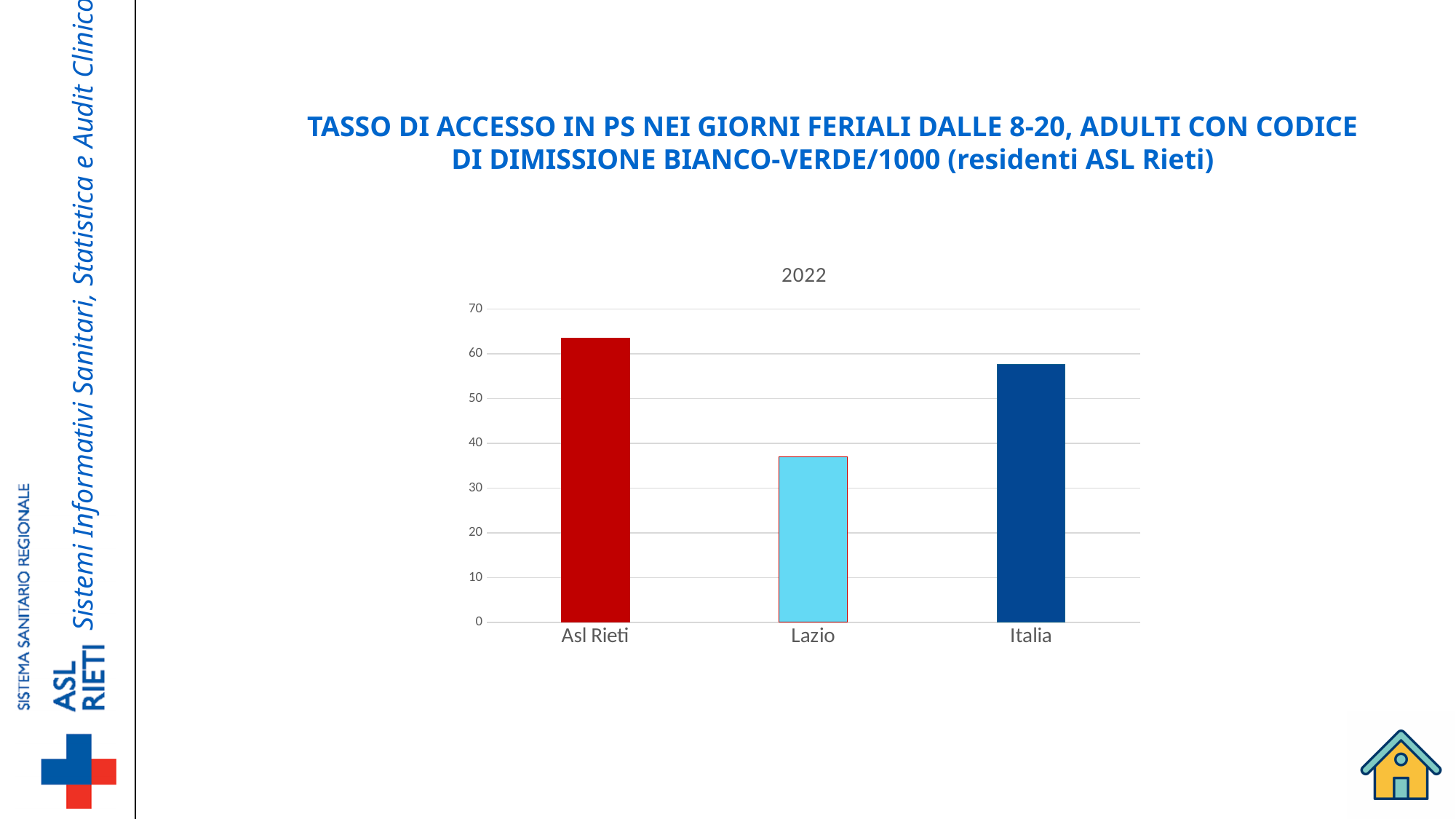
Is the value for Asl Rieti greater or less than 60? greater What colour is the bar for Lazio? light blue What year is shown as the chart title above the plot area? 2022 Is the value for Lazio greater or less than 40? less Which category has the lowest value? Lazio How many categories are plotted on the x axis? 3 Is the value for Italia greater or less than 60? less What kind of chart is shown on the slide? bar chart Which is larger, the value for Asl Rieti or the value for Italia? Asl Rieti Which is larger, the value for Lazio or the value for Italia? Italia Which category has the highest value? Asl Rieti